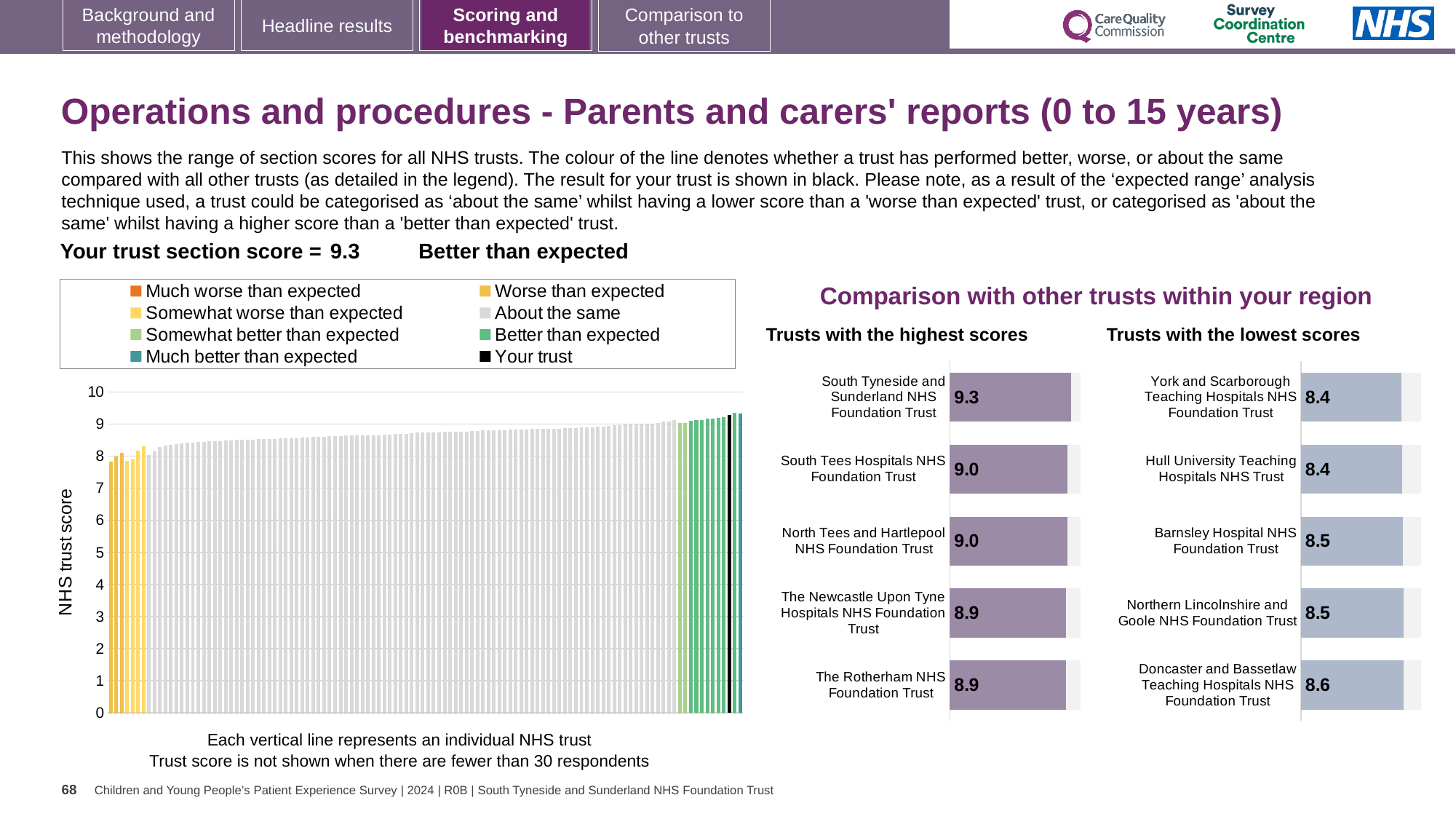
In the large chart on the left, is the value of the black bar for your trust greater or less than 9? greater In the 'Trusts with the lowest scores' chart, what is the score for Hull University Teaching Hospitals NHS Trust? 8.4 In the 'Trusts with the highest scores' chart, what is the score for The Newcastle Upon Tyne Hospitals NHS Foundation Trust? 8.9 In the 'Trusts with the highest scores' chart, what is the difference between the scores of South Tyneside and Sunderland NHS Foundation Trust and The Rotherham NHS Foundation Trust? 0.4 How many trusts are shown in the 'Trusts with the lowest scores' chart? 5 In the 'Trusts with the highest scores' chart, which has the larger score: South Tees Hospitals NHS Foundation Trust or The Newcastle Upon Tyne Hospitals NHS Foundation Trust? South Tees Hospitals NHS Foundation Trust In the 'Trusts with the lowest scores' chart, what is the score for Doncaster and Bassetlaw Teaching Hospitals NHS Foundation Trust? 8.6 In the 'Trusts with the highest scores' chart, which trust has the highest score? South Tyneside and Sunderland NHS Foundation Trust In the 'Trusts with the lowest scores' chart, which trust has the highest score shown? Doncaster and Bassetlaw Teaching Hospitals NHS Foundation Trust In the 'Trusts with the highest scores' chart, what is the score for South Tyneside and Sunderland NHS Foundation Trust? 9.3 In the 'Trusts with the lowest scores' chart, what is the difference between the scores of Doncaster and Bassetlaw Teaching Hospitals NHS Foundation Trust and York and Scarborough Teaching Hospitals NHS Foundation Trust? 0.2 How many entries does the legend of the large chart on the left list? 8